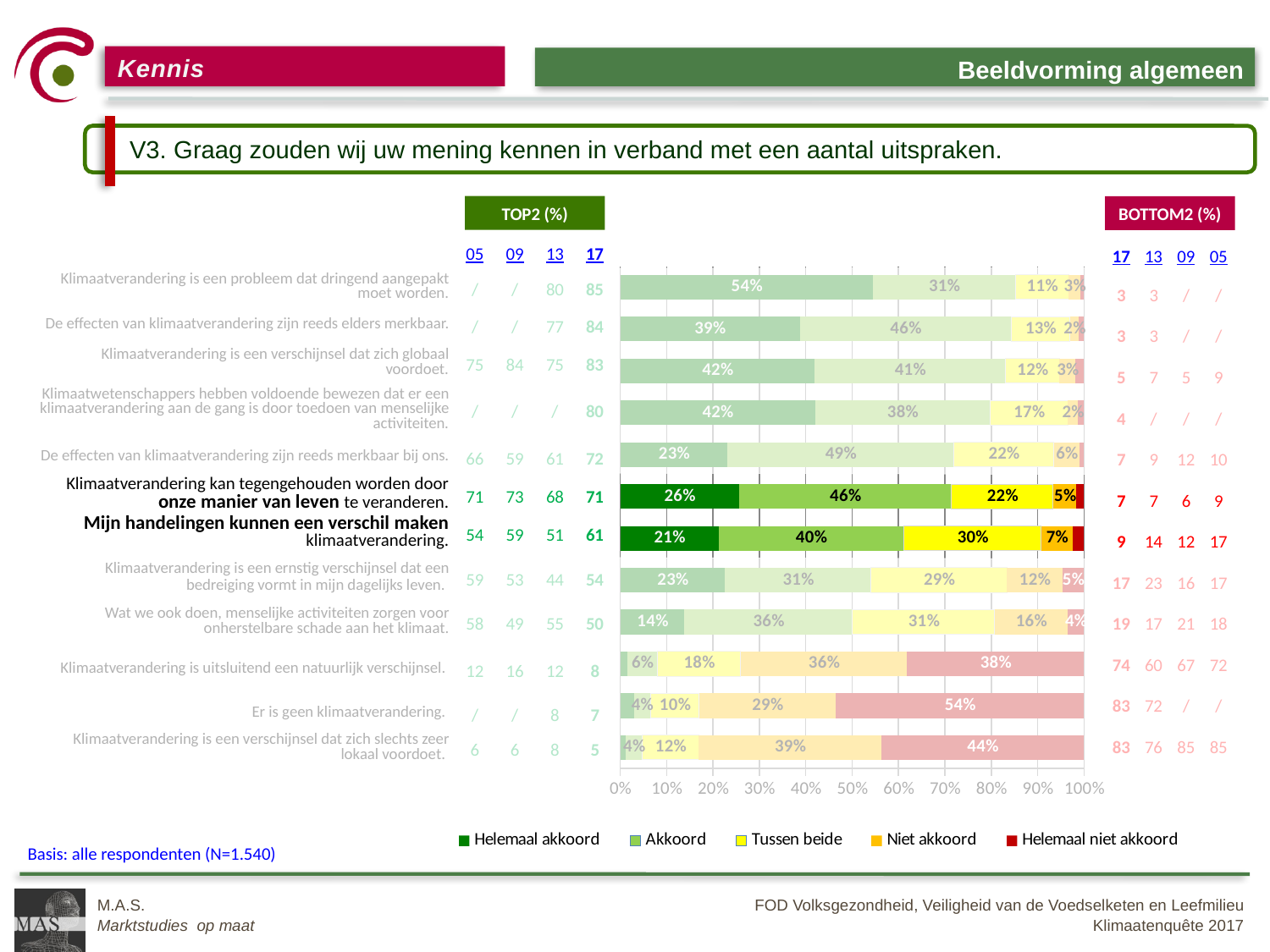
What is the difference between the 'Akkoord' values for 'De effecten van klimaatverandering zijn reeds merkbaar bij ons' (49%) and 'Mijn handelingen kunnen een verschil maken klimaatverandering' (40%)? 9% What is the 'Helemaal niet akkoord' value for the statement 'Er is geen klimaatverandering'? 54% How many statements (categories) are plotted in the chart? 12 What is the 'Helemaal akkoord' value for the statement 'Klimaatverandering is een probleem dat dringend aangepakt moet worden'? 54% What is the 'Akkoord' value for the statement 'Mijn handelingen kunnen een verschil maken klimaatverandering'? 40% Which colour represents 'Tussen beide' in the chart legend? yellow What kind of chart is shown on the slide? stacked bar chart Which is larger: the 'Tussen beide' value for 'Mijn handelingen kunnen een verschil maken klimaatverandering' or for 'Klimaatverandering kan tegengehouden worden door onze manier van leven te veranderen'? Mijn handelingen kunnen een verschil maken klimaatverandering Which statement has the highest 'Helemaal niet akkoord' value? Er is geen klimaatverandering Which statement has the highest 'Helemaal akkoord' value? Klimaatverandering is een probleem dat dringend aangepakt moet worden What is the 'Tussen beide' value for the statement 'Klimaatverandering kan tegengehouden worden door onze manier van leven te veranderen'? 22% How many series does the chart legend list? 5